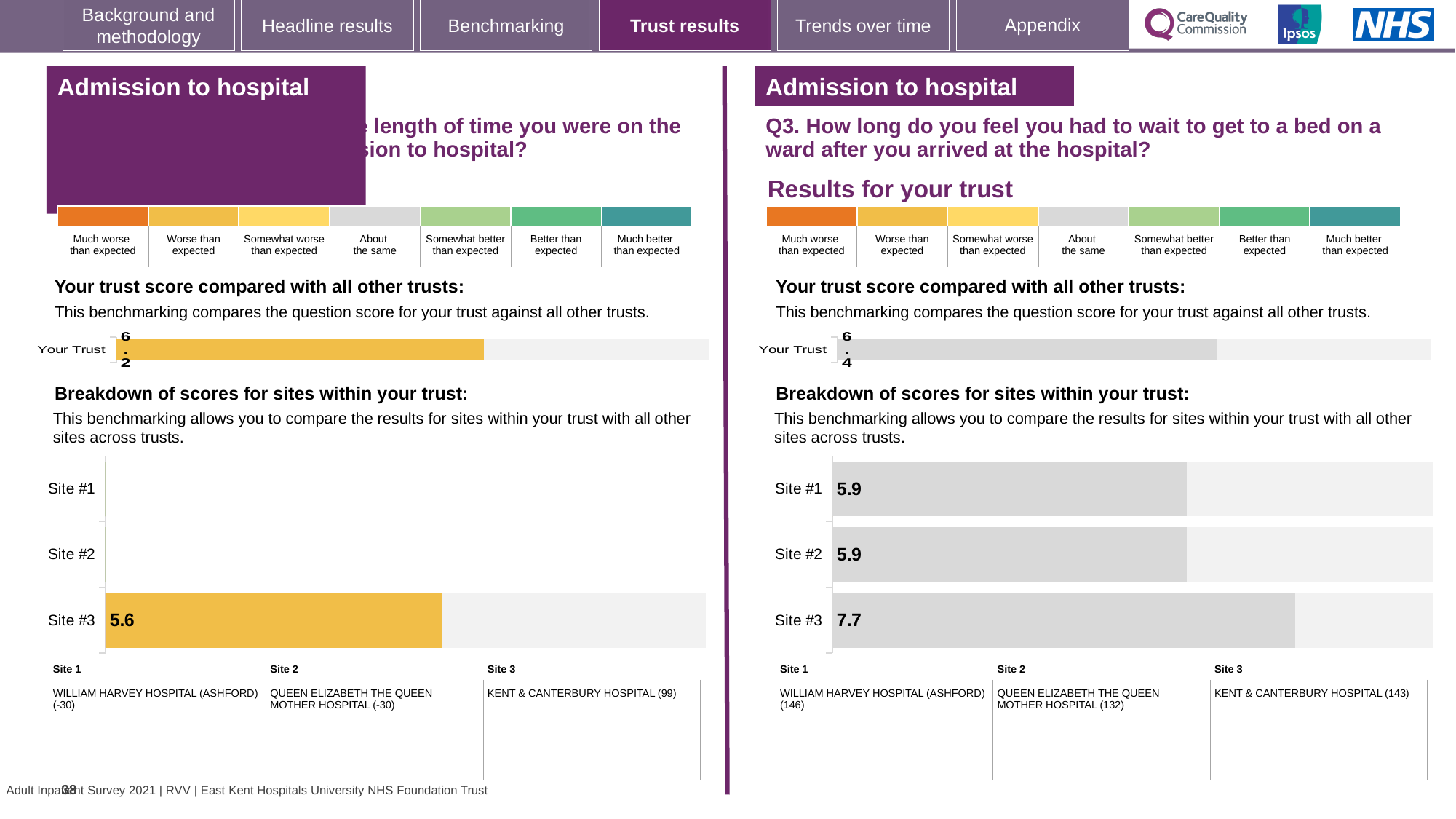
On the right-hand 'Breakdown of scores for sites within your trust' chart, what is the score for Site #3? 7.7 On the left-hand 'Your Trust' chart, what is the trust score? 6.2 On the right-hand site breakdown chart, which site has the highest score? Site #3 What kind of chart is the right-hand site breakdown chart? Bar chart What colour is the 'Your Trust' bar on the right-hand Q3 chart? Grey On the left-hand 'Breakdown of scores for sites within your trust' chart, what is the score for Site #3? 5.6 On the right-hand site breakdown chart, what is the difference between the scores for Site #3 and Site #2? 1.8 On the left-hand site breakdown chart, which site is the only one with a plotted bar? Site #3 On the right-hand site breakdown chart, which is larger, the score for Site #3 or the score for Site #1? Site #3 How many sites are listed on the right-hand site breakdown chart? 3 On the right-hand 'Breakdown of scores for sites within your trust' chart, what is the score for Site #1? 5.9 On the right-hand 'Your Trust' chart for Q3, what is the trust score? 6.4